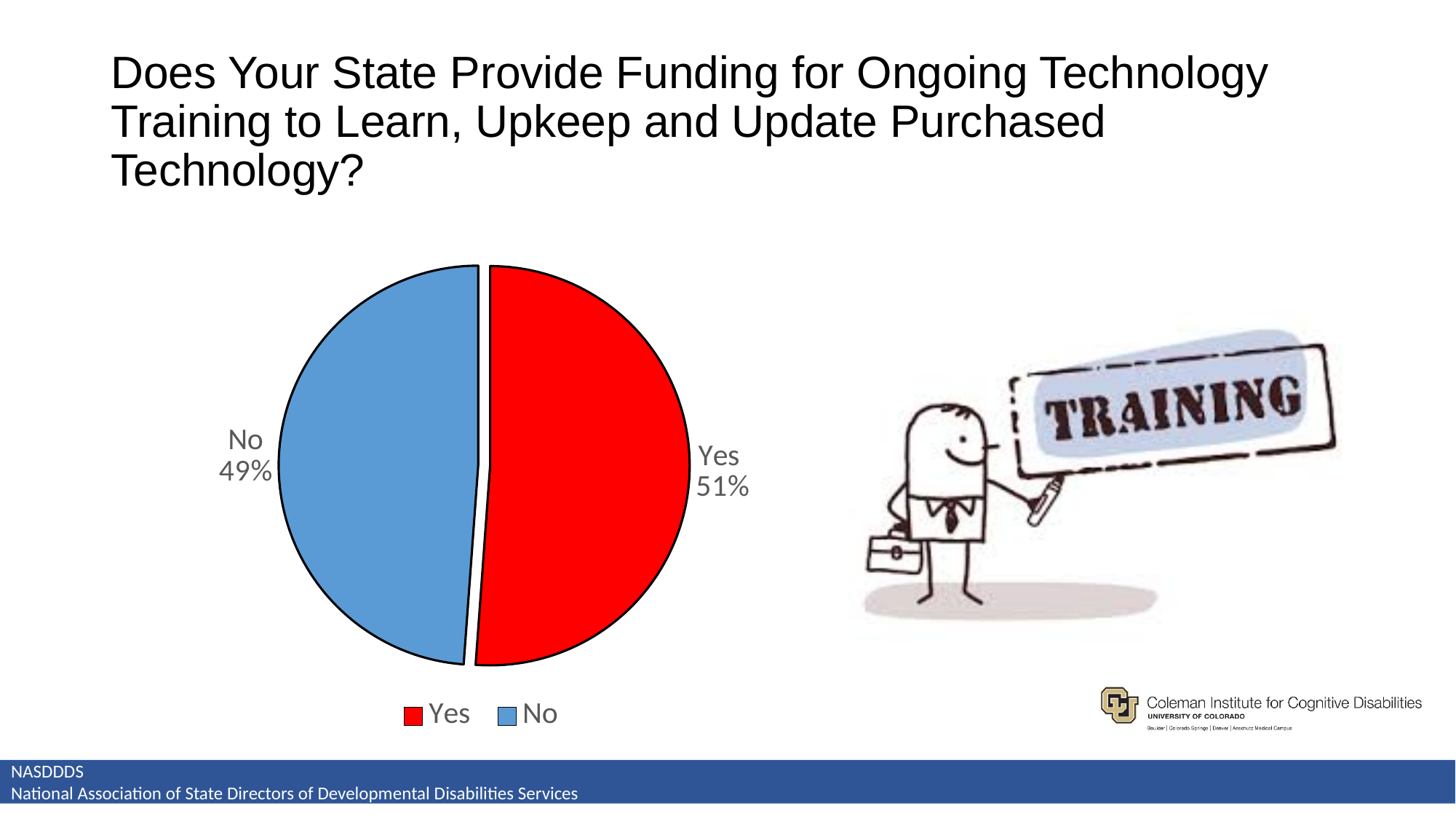
What colour is the Yes slice of the pie chart? red How many slices does the pie chart have? 2 What percentage of respondents answered No? 49% What kind of chart is shown on the slide? pie chart What percentage of respondents answered Yes? 51% How many entries does the legend list? 2 Is the share for Yes larger or smaller than the share for No? larger What is the difference in percentage points between the Yes and No shares? 2 What share of the pie does the No slice represent? 49% What colour is the No slice of the pie chart? blue Which response has the larger share of the pie? Yes Which response has the smaller share of the pie? No